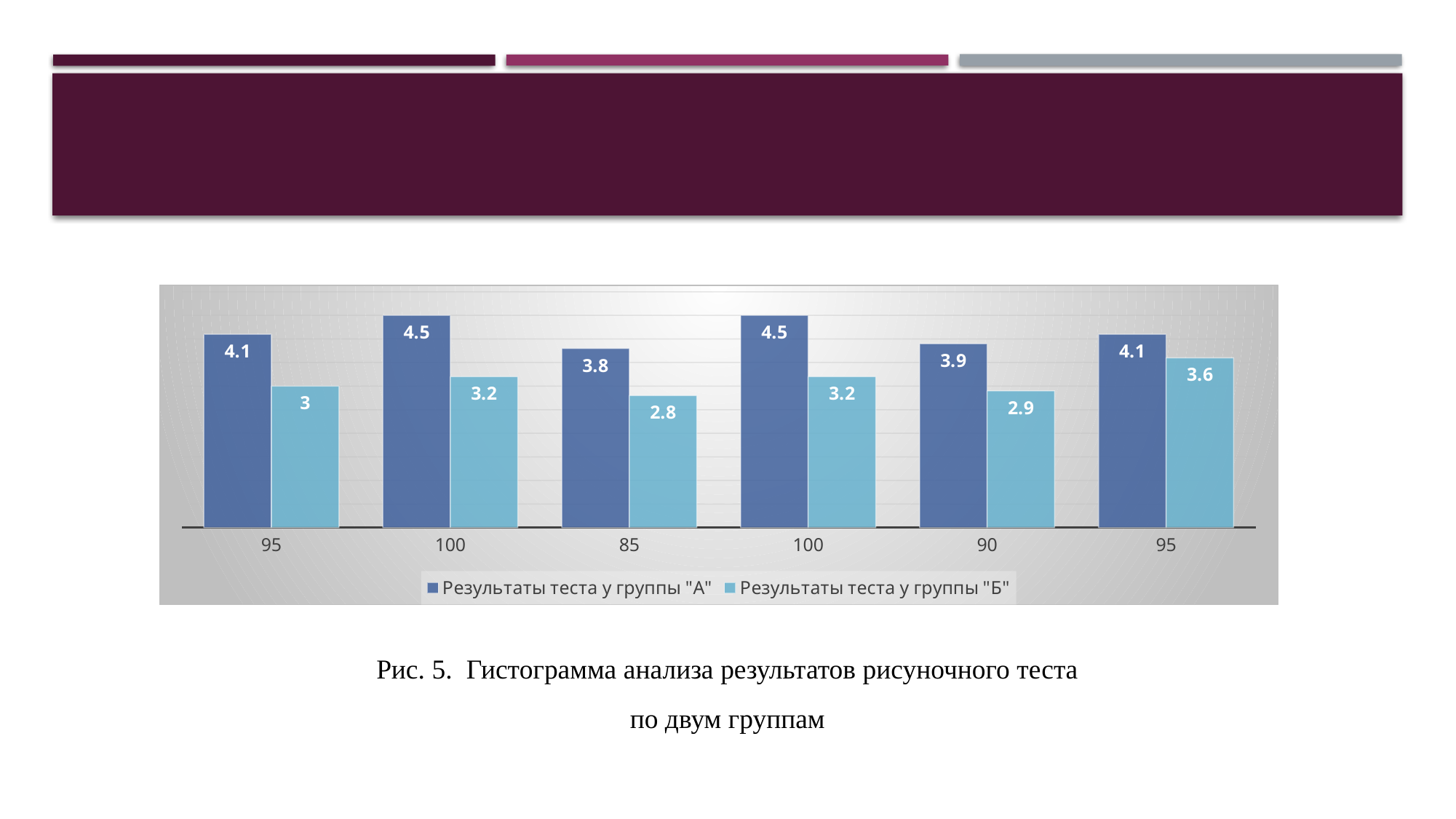
How many series does the legend list? 2 What is the value for group "А" (Результаты теста у группы "А") in the third category, labelled 85? 3.8 What is the difference between the group "А" and group "Б" values in the first category, labelled 95? 1.1 What is the difference between the group "Б" values in the sixth category (95) and the third category (85)? 0.8 What is the highest value shown for group "А"? 4.5 What is the legend entry for the darker blue series? Результаты теста у группы "А" What is the value for group "Б" in the last (sixth) category, labelled 95? 3.6 In the third category, labelled 85, which group has the larger value, "А" or "Б"? Группа "А" How many categories are shown along the x axis? 6 What is the lowest value shown for group "Б"? 2.8 What type of chart is shown on the slide? bar chart What is the value for group "Б" (Результаты теста у группы "Б") in the fifth category, labelled 90? 2.9